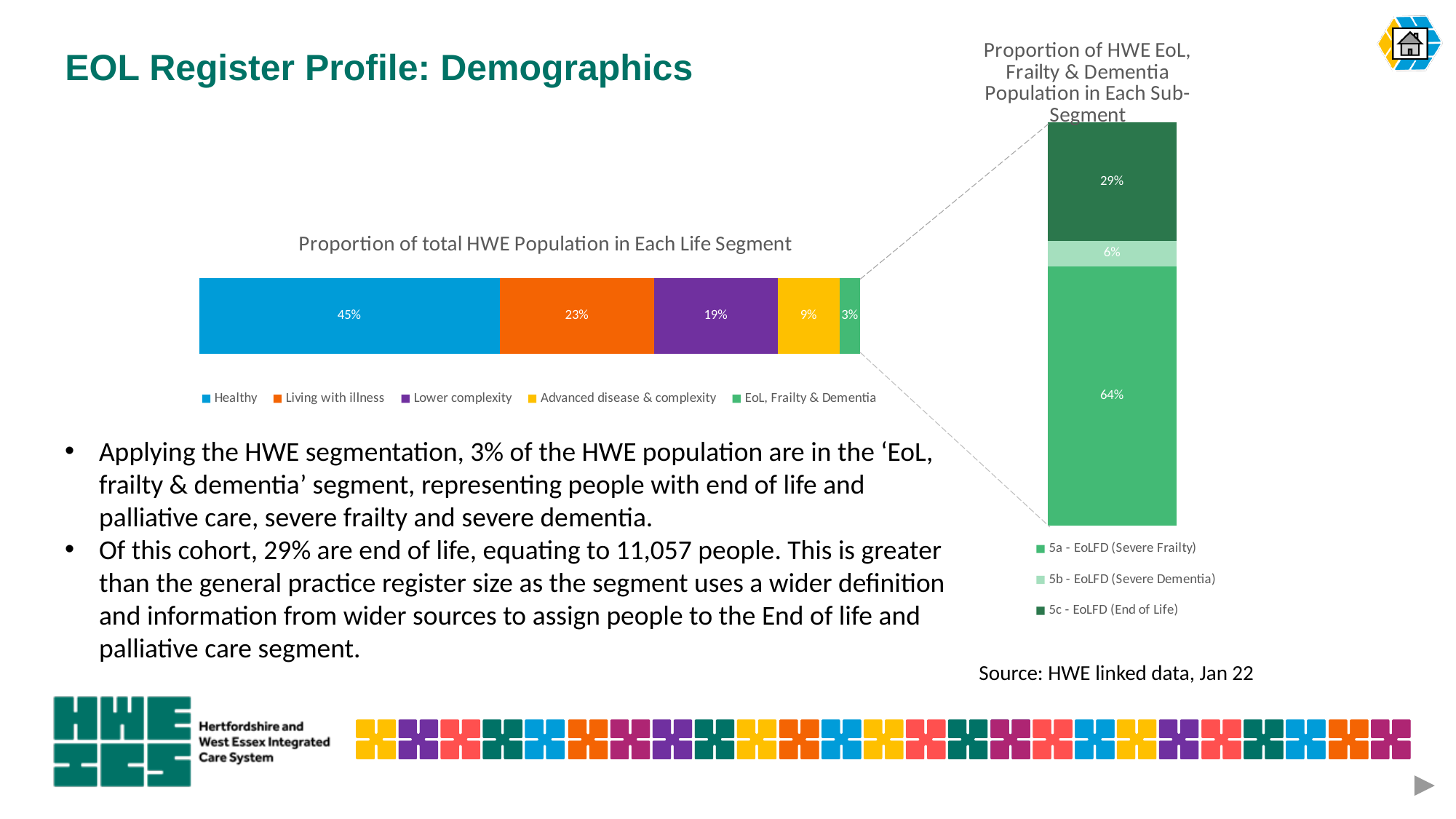
In the chart 'Proportion of HWE EoL, Frailty & Dementia Population in Each Sub-Segment', what percentage is shown for 5a - EoLFD (Severe Frailty)? 64% In the chart 'Proportion of total HWE Population in Each Life Segment', which segment has the largest share? Healthy What kind of chart is 'Proportion of total HWE Population in Each Life Segment'? Stacked bar chart In the chart 'Proportion of total HWE Population in Each Life Segment', how many segments does the legend list? 5 In the chart 'Proportion of total HWE Population in Each Life Segment', what percentage is shown for EoL, Frailty & Dementia? 3% In the chart 'Proportion of total HWE Population in Each Life Segment', what is the difference between the Living with illness and Lower complexity percentages? 4% In the chart 'Proportion of HWE EoL, Frailty & Dementia Population in Each Sub-Segment', which is larger: Severe Frailty or End of Life? Severe Frailty In the chart 'Proportion of HWE EoL, Frailty & Dementia Population in Each Sub-Segment', what percentage is shown for 5c - EoLFD (End of Life)? 29% In the chart 'Proportion of total HWE Population in Each Life Segment', what percentage is shown for Living with illness? 23% In the chart 'Proportion of HWE EoL, Frailty & Dementia Population in Each Sub-Segment', which sub-segment has the smallest share? 5b - EoLFD (Severe Dementia) In the chart 'Proportion of total HWE Population in Each Life Segment', what percentage is shown for Healthy? 45% In the chart 'Proportion of total HWE Population in Each Life Segment', which segment has the smallest share? EoL, Frailty & Dementia